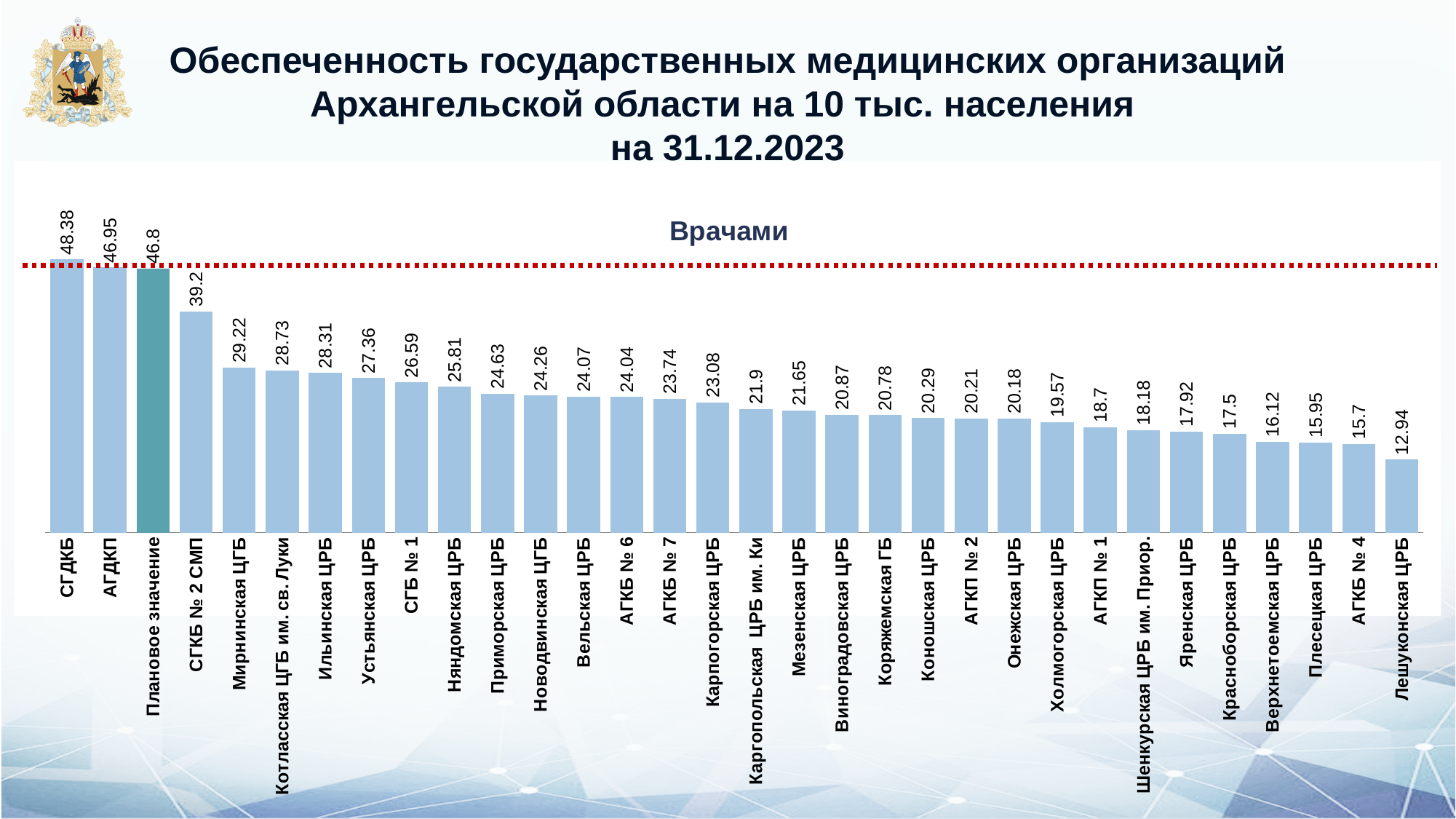
Which category has the highest value? СГДКБ What is the difference between the values for СГДКБ and АГДКП? 1.43 What is the value shown for Плановое значение? 46.8 Which is larger, the value for Устьянская ЦРБ or the value for Няндомская ЦРБ? Устьянская ЦРБ What is the difference between the values for СГКБ № 2 СМП and Плановое значение? 7.6 What kind of chart is shown on the slide? Bar chart What is the value for Коряжемская ГБ? 20.78 Which category has the lowest value? Лешуконская ЦРБ How many bars are shown in the chart? 32 What is the value for Лешуконская ЦРБ? 12.94 What is the title of the chart? Врачами